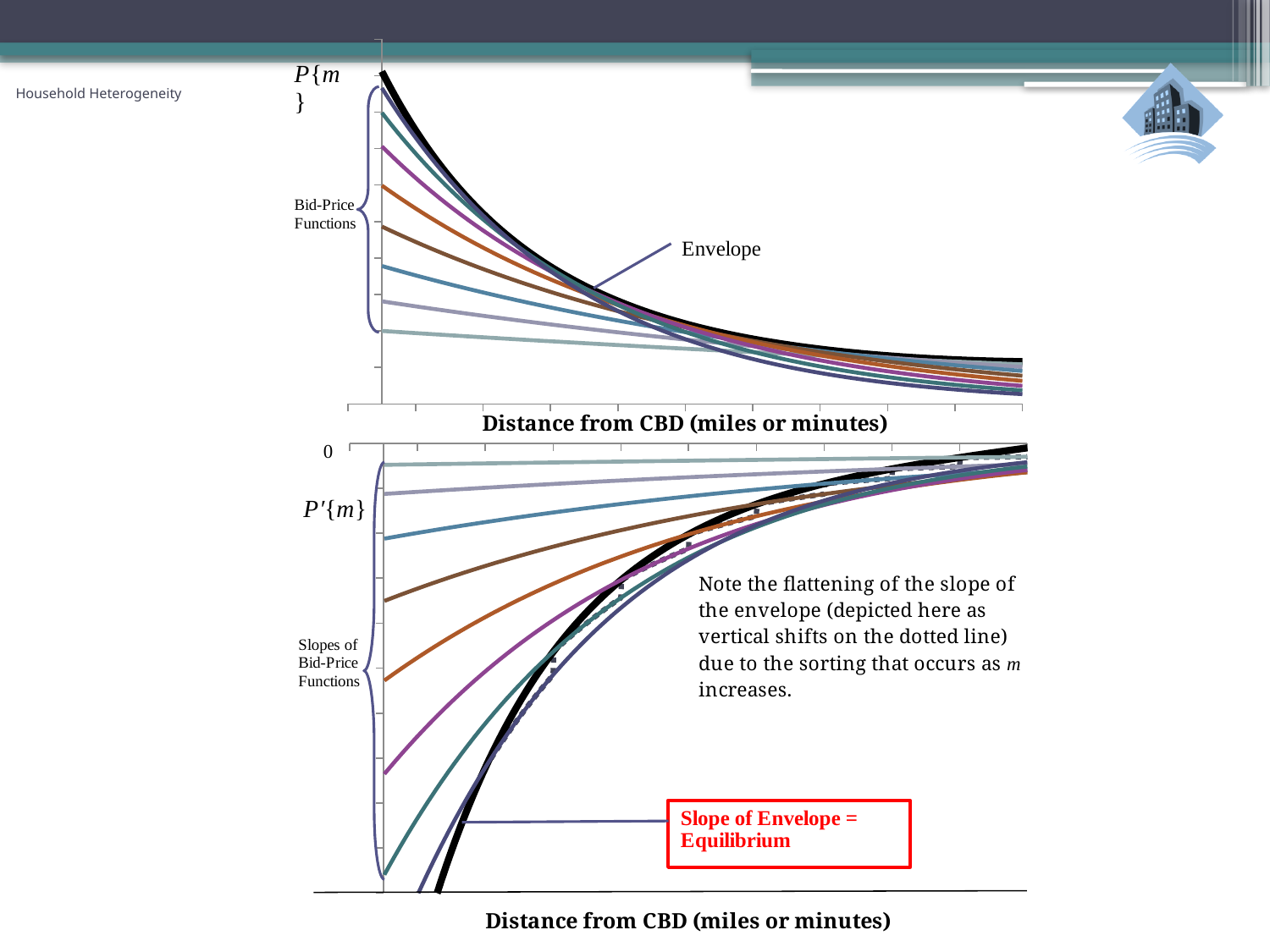
In the bottom chart, do the slopes of the bid-price functions rise or fall as distance from CBD increases? Rise In the top chart, does the thick black envelope curve rise or fall as distance from CBD increases? Fall What is the x-axis label of the top chart? Distance from CBD (miles or minutes) How many coloured bid-price function curves are plotted in the top chart (excluding the black envelope)? 8 What does the thick black curve in the top chart represent, according to the label on the slide? Envelope What kind of chart is the bottom chart on the slide? Line chart In the bottom chart, are the slopes of the bid-price functions greater or less than 0? less In the bottom chart, what value is marked at the top of the vertical axis? 0 In the top chart, do the bid-price functions rise or fall as distance from CBD increases? Fall What kind of chart is the top chart on the slide? Line chart